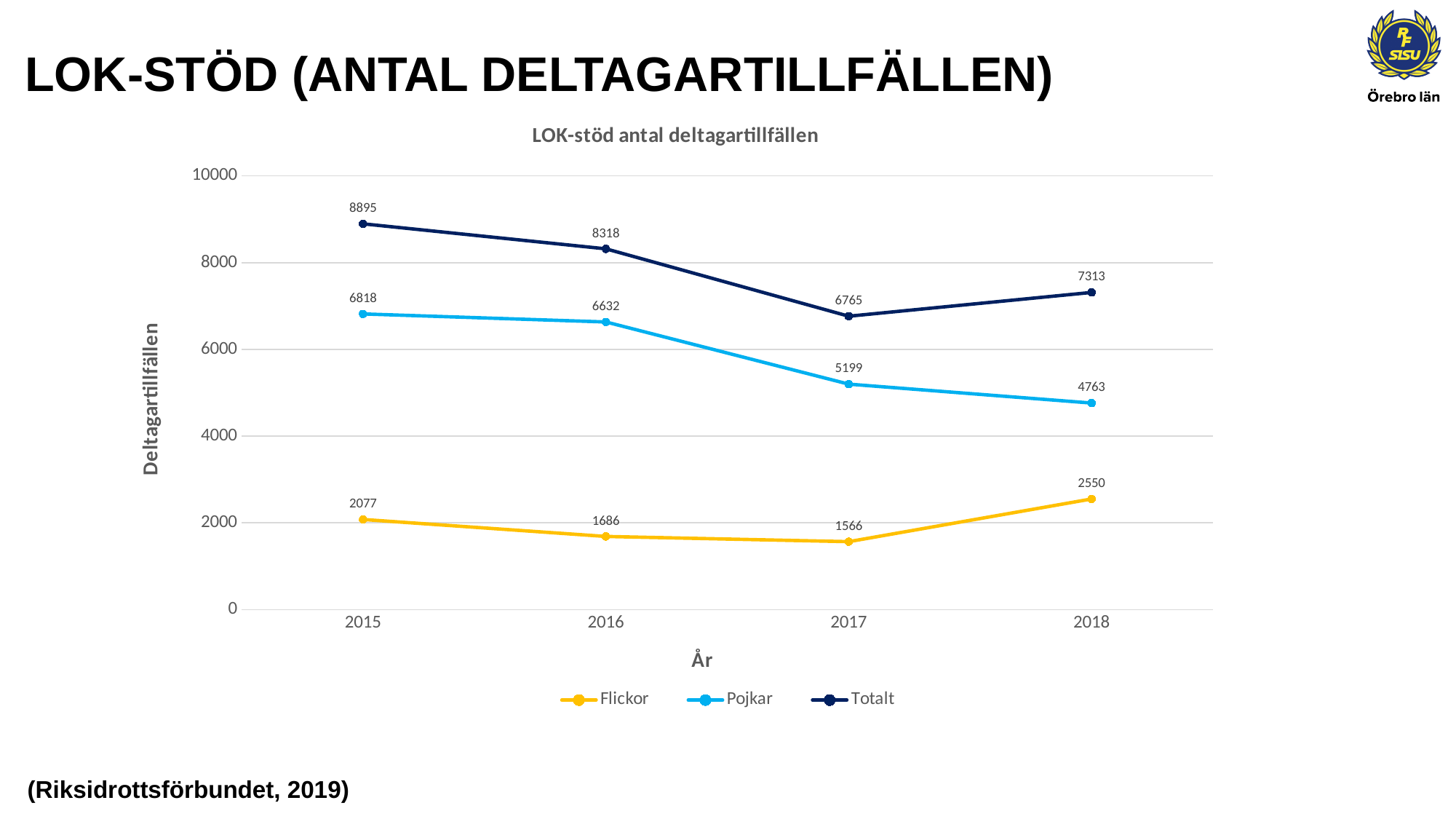
Which is larger, the Pojkar value in 2016 or the Pojkar value in 2018? 2016 How many years are shown on the x axis? 4 In which year is the Flickor series lowest? 2017 What is the value for Pojkar in 2017? 5199 What is the difference between the Totalt values for 2015 and 2018? 1582 What kind of chart is shown? line chart In which year is the Pojkar series highest? 2015 Is the value for Totalt in 2017 greater or less than 8000? less How many series does the legend list? 3 Does the Pojkar series rise or fall from 2015 to 2018? fall What is the value for Totalt in 2015? 8895 What is the value for Flickor in 2018? 2550